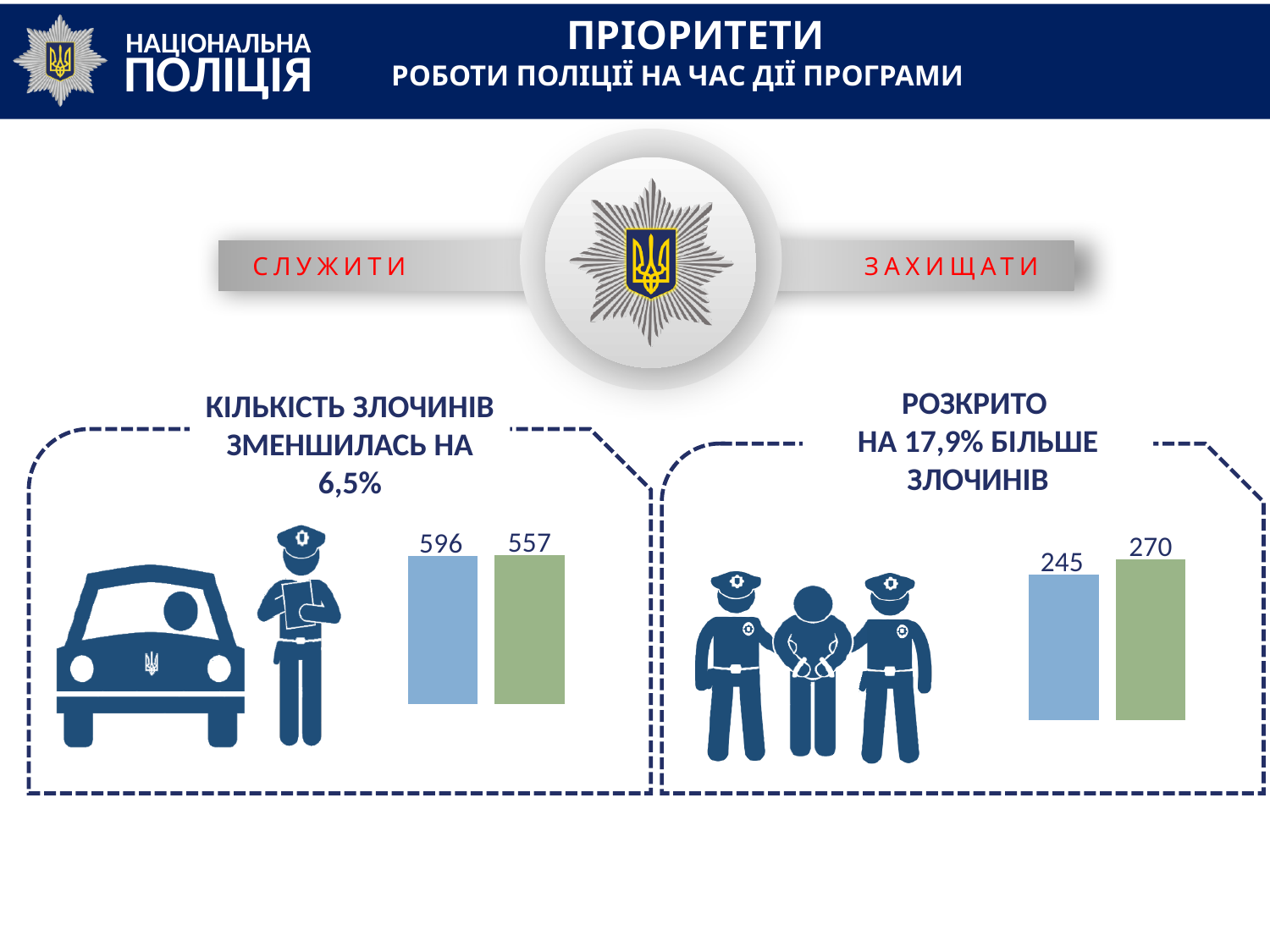
What percentage is stated in the heading above the left chart? 6,5% What kind of chart is shown in the right box (РОЗКРИТО НА 17,9% БІЛЬШЕ ЗЛОЧИНІВ)? bar chart In the left chart (КІЛЬКІСТЬ ЗЛОЧИНІВ ЗМЕНШИЛАСЬ НА 6,5%), what value is printed above the blue bar? 596 In the left chart (КІЛЬКІСТЬ ЗЛОЧИНІВ ЗМЕНШИЛАСЬ НА 6,5%), which bar has the larger printed value, the blue one or the green one? the blue one What percentage is stated in the heading above the right chart? 17,9% In the left chart (КІЛЬКІСТЬ ЗЛОЧИНІВ ЗМЕНШИЛАСЬ НА 6,5%), what is the difference between the two printed values, 596 and 557? 39 In the right chart (РОЗКРИТО НА 17,9% БІЛЬШЕ ЗЛОЧИНІВ), what value is printed above the green bar? 270 How many bars does the left chart (КІЛЬКІСТЬ ЗЛОЧИНІВ ЗМЕНШИЛАСЬ НА 6,5%) contain? 2 In the right chart (РОЗКРИТО НА 17,9% БІЛЬШЕ ЗЛОЧИНІВ), what is the difference between the two printed values, 270 and 245? 25 In the left chart (КІЛЬКІСТЬ ЗЛОЧИНІВ ЗМЕНШИЛАСЬ НА 6,5%), what value is printed above the green bar? 557 In the right chart (РОЗКРИТО НА 17,9% БІЛЬШЕ ЗЛОЧИНІВ), which bar has the larger printed value, the blue one or the green one? the green one In the right chart (РОЗКРИТО НА 17,9% БІЛЬШЕ ЗЛОЧИНІВ), what value is printed above the blue bar? 245